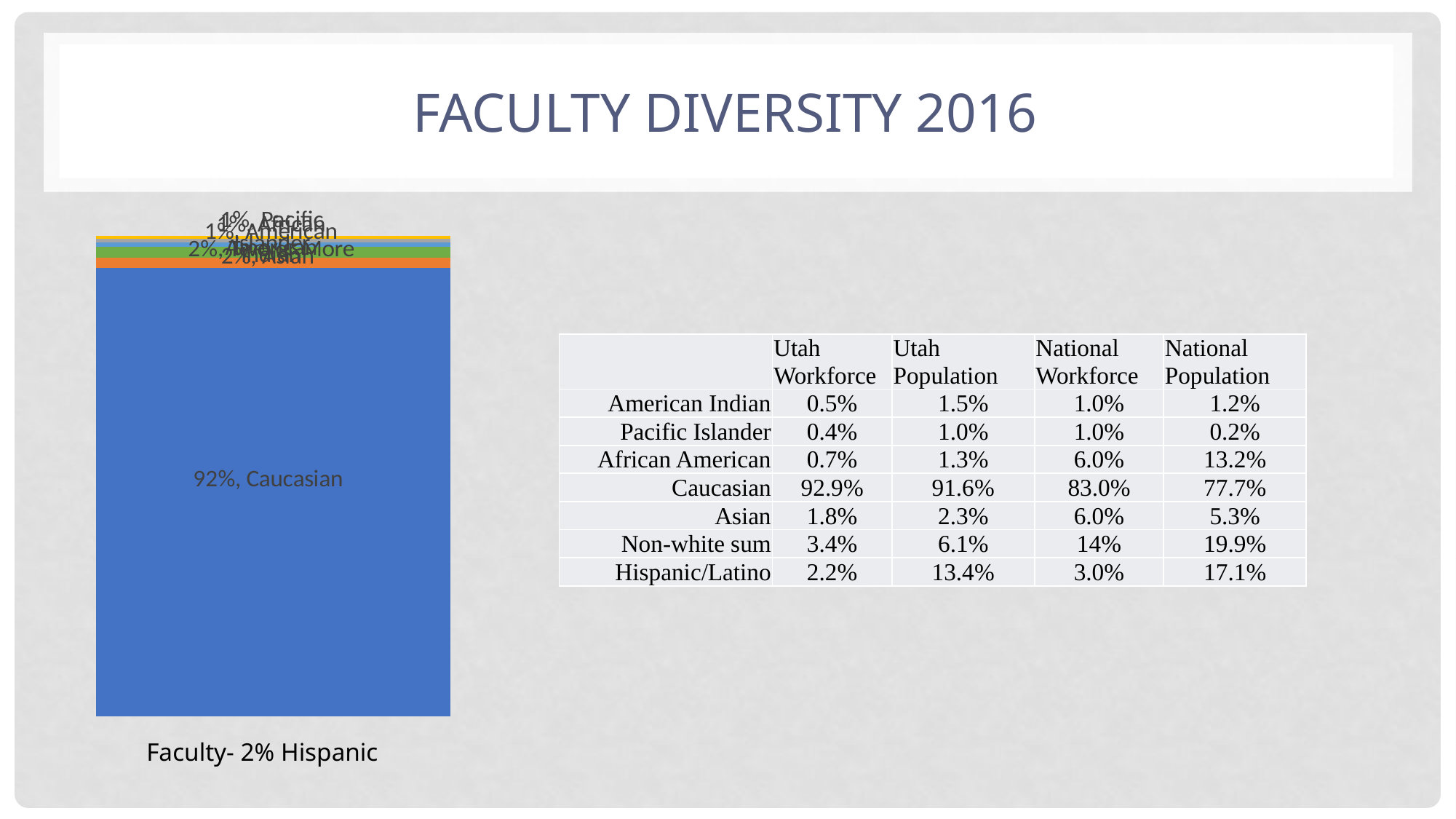
What colour is the Caucasian segment of the stacked bar? Blue What kind of chart is shown on the left of the slide? Stacked bar chart In the stacked bar chart, what percentage is labelled for Caucasian? 92% Which category makes up the largest segment of the stacked bar? Caucasian What caption appears directly below the stacked bar chart? Faculty- 2% Hispanic